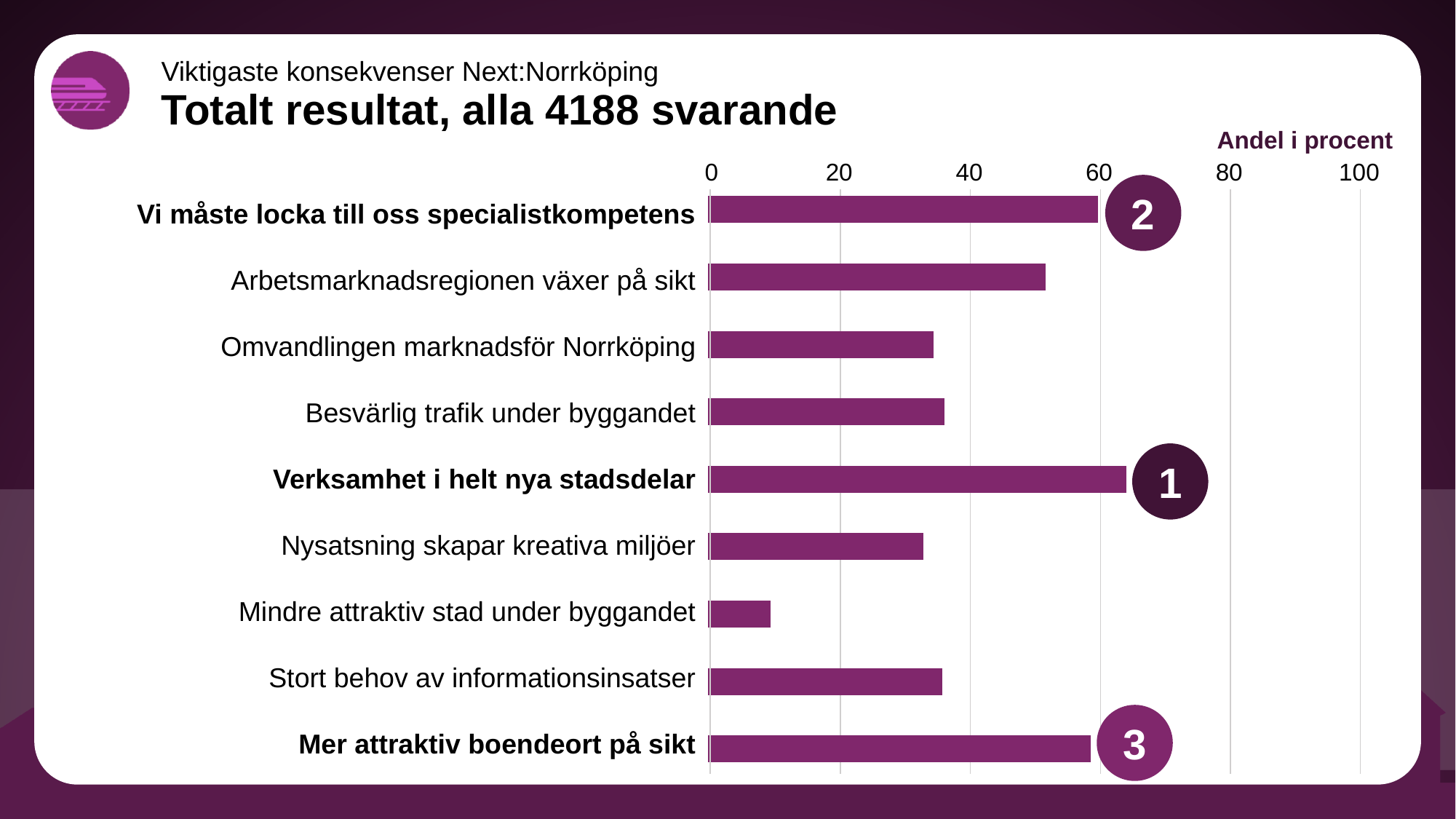
What kind of chart is shown on the slide? bar chart Is the value for Nysatsning skapar kreativa miljöer greater or less than 40? less Which category has the highest value? Verksamhet i helt nya stadsdelar What is the label shown above the horizontal axis of the chart? Andel i procent Which is larger: the value for Arbetsmarknadsregionen växer på sikt or for Omvandlingen marknadsför Norrköping? Arbetsmarknadsregionen växer på sikt Which category has the lowest value? Mindre attraktiv stad under byggandet How many categories are plotted in the chart? 9 Is the value for Mindre attraktiv stad under byggandet greater or less than 20? less Which is larger: the value for Stort behov av informationsinsatser or for Mindre attraktiv stad under byggandet? Stort behov av informationsinsatser Is the value for Arbetsmarknadsregionen växer på sikt greater or less than 40? greater What number is shown in the circle next to the bar for Verksamhet i helt nya stadsdelar? 1